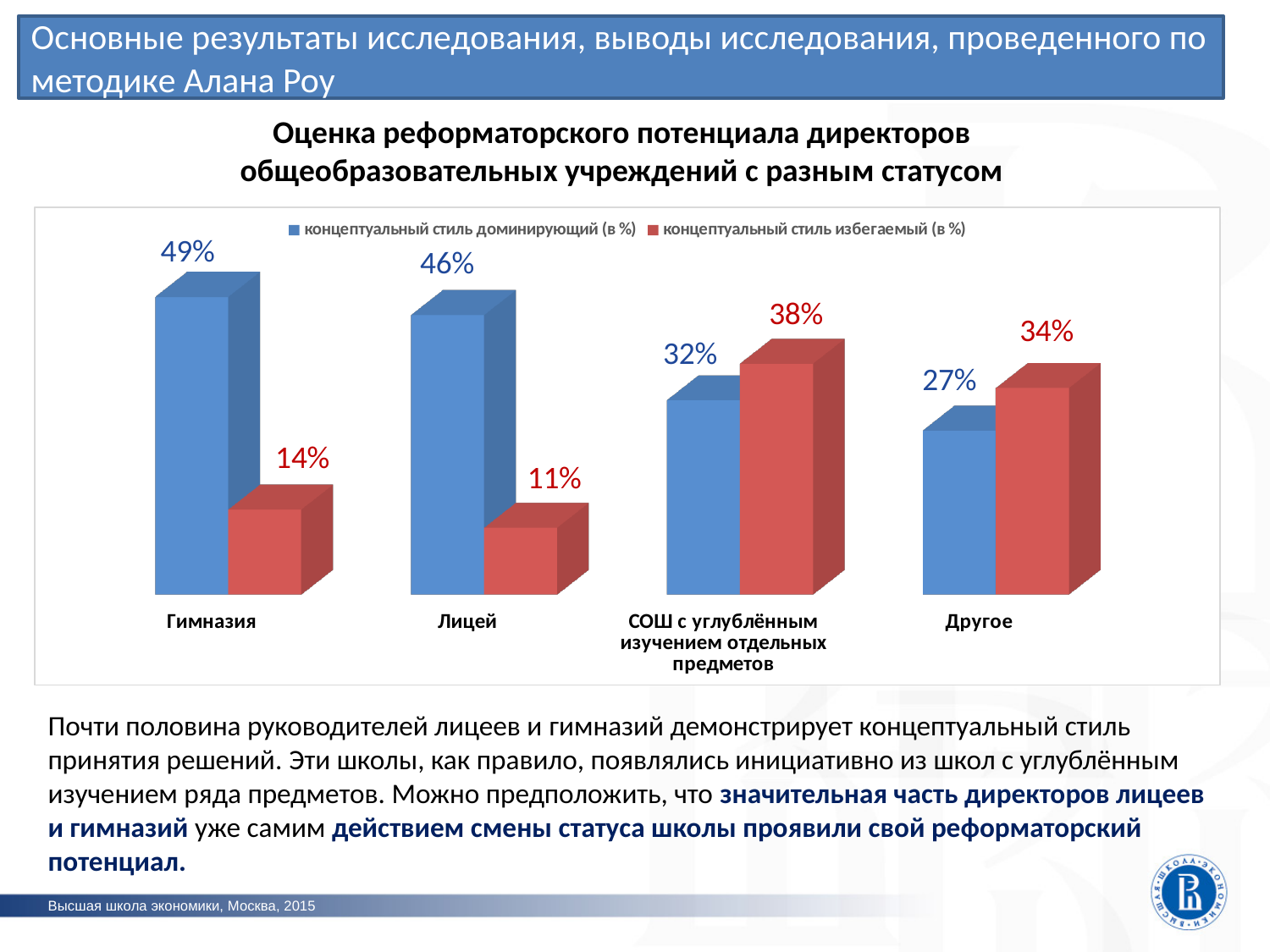
Does the value of 'концептуальный стиль доминирующий (в %)' rise or fall from Гимназия to Другое? Fall What kind of chart is shown on the slide? Bar chart What is the value of 'концептуальный стиль доминирующий (в %)' for Гимназия? 49% What is the difference between the two series values for Гимназия? 35% How many categories are shown on the x axis of the chart? 4 What is the value of 'концептуальный стиль избегаемый (в %)' for СОШ с углублённым изучением отдельных предметов? 38% Which category has the lowest value for 'концептуальный стиль избегаемый (в %)'? Лицей What is the value of 'концептуальный стиль доминирующий (в %)' for Другое? 27% For Другое, which series has the larger value: 'концептуальный стиль доминирующий (в %)' or 'концептуальный стиль избегаемый (в %)'? концептуальный стиль избегаемый (в %) How many series does the legend list? 2 What is the value of 'концептуальный стиль избегаемый (в %)' for Лицей? 11% Which category has the highest value for 'концептуальный стиль доминирующий (в %)'? Гимназия